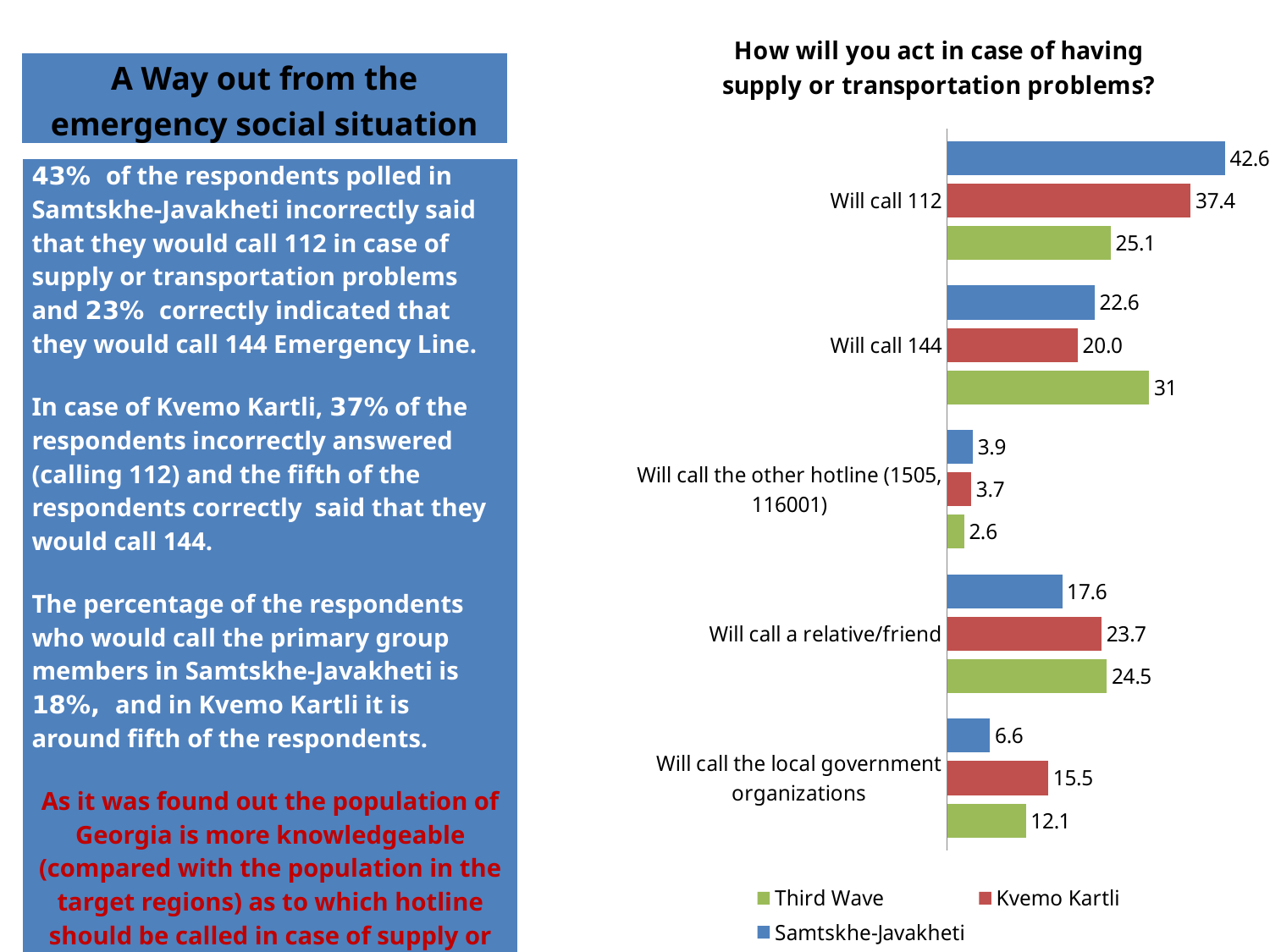
How many series does the legend list? 3 What kind of chart is shown on the slide? Bar chart What is the Third Wave value for "Will call 144"? 31 How many categories are shown on the chart? 5 What is the Samtskhe-Javakheti value for "Will call 112"? 42.6 What is the difference between the Samtskhe-Javakheti and Kvemo Kartli values for "Will call 112"? 5.2 What is the title of the chart? How will you act in case of having supply or transportation problems? What is the Kvemo Kartli value for "Will call the local government organizations"? 15.5 Which series is shown in green in the legend? Third Wave For "Will call a relative/friend", which is larger: the Third Wave value or the Samtskhe-Javakheti value? Third Wave Which category has the lowest Third Wave value? Will call the other hotline (1505, 116001) Which category has the highest Kvemo Kartli value? Will call 112